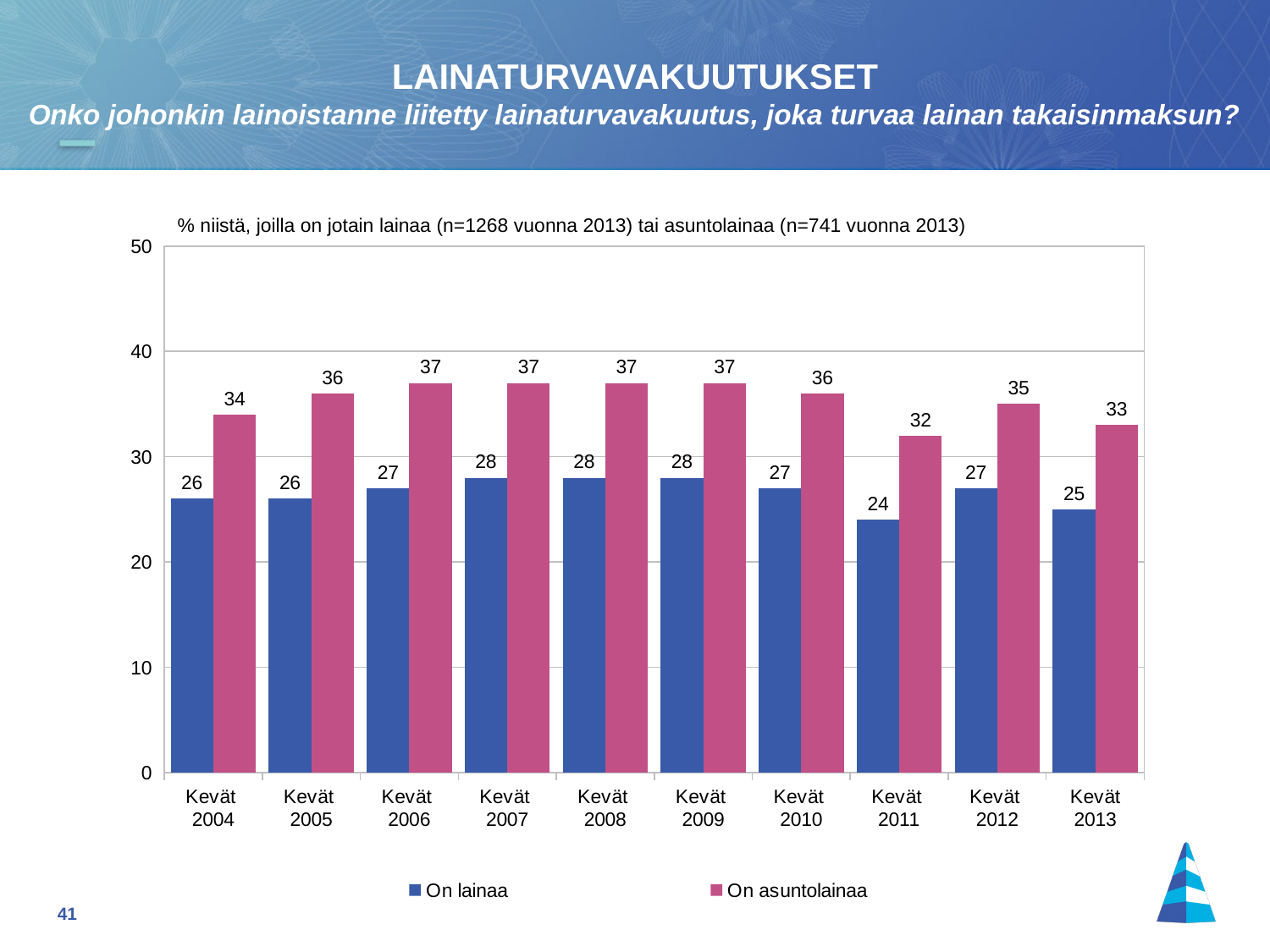
What is the value for "On lainaa" in Kevät 2011? 24 What is the value for "On asuntolainaa" in Kevät 2004? 34 Which is larger in Kevät 2010: "On lainaa" or "On asuntolainaa"? On asuntolainaa What is the difference between the "On asuntolainaa" values in Kevät 2012 and Kevät 2013? 2 In which year is the "On lainaa" value lowest? Kevät 2011 What kind of chart is shown on the slide? Bar chart How many years (categories) are shown on the x axis? 10 What is the value for "On asuntolainaa" in Kevät 2013? 33 How many series does the legend list? 2 Which series is shown in pink/magenta in the legend? On asuntolainaa What is the difference between "On asuntolainaa" and "On lainaa" in Kevät 2006? 10 In which year is the "On asuntolainaa" value lowest? Kevät 2011